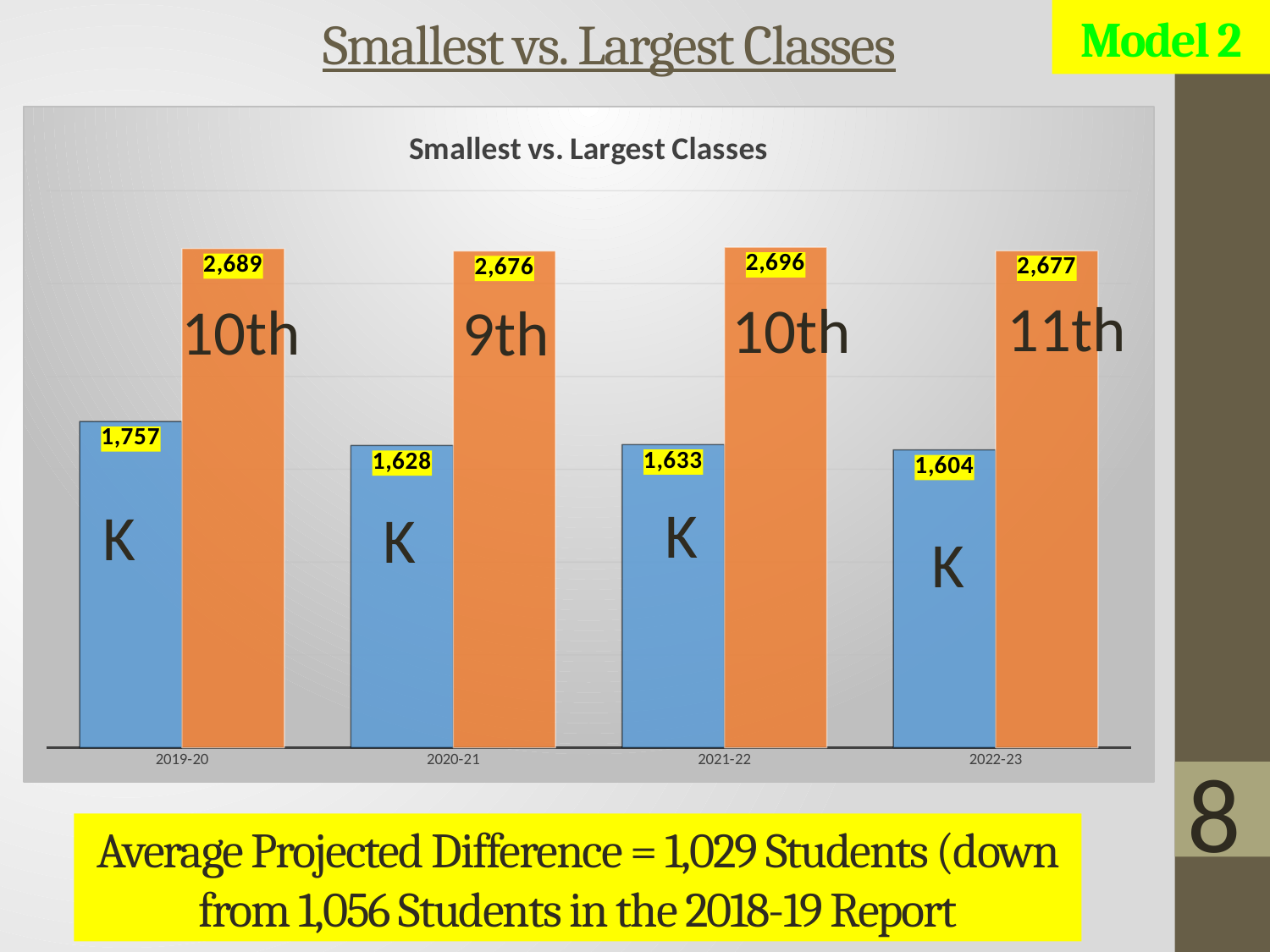
What is the value of the largest class (orange bar) for 2022-23? 2,677 What is the difference between the largest and smallest class values for 2022-23? 1,073 In which school year is the smallest class (blue bar) lowest? 2022-23 How many school years are shown on the x axis? 4 What is the difference between the largest and smallest class values for 2019-20? 932 Which grade is labelled as the largest class in 2022-23? 11th What type of chart is shown on the slide? Bar chart In which school year is the largest class (orange bar) highest? 2021-22 What is the value of the smallest class (blue bar) for 2020-21? 1,628 What is the value of the smallest class (blue bar) for 2019-20? 1,757 Which is larger: the smallest class value for 2019-20 or for 2021-22? 2019-20 What is the value of the largest class (orange bar) for 2021-22? 2,696